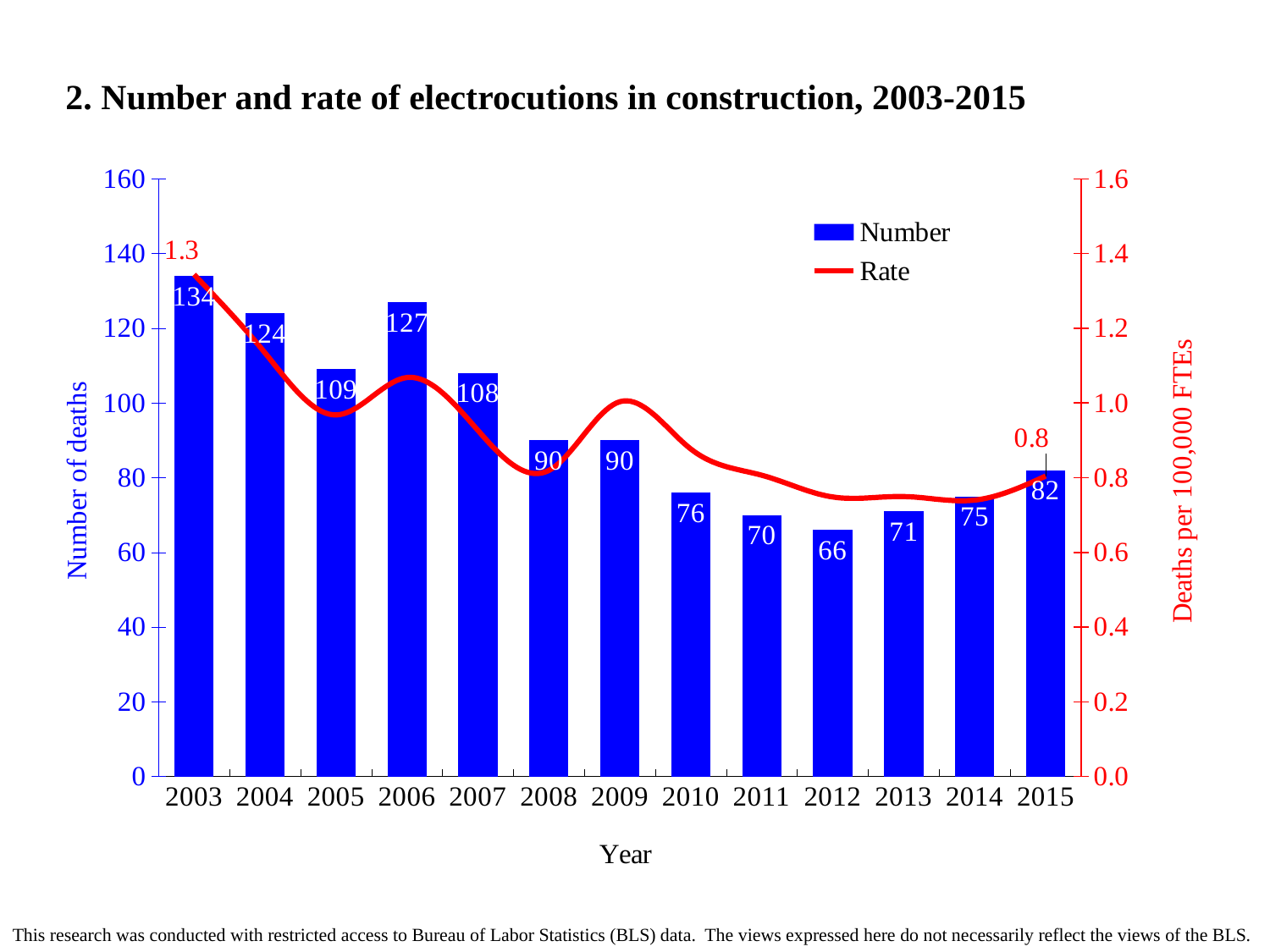
What kind of chart is used to show the number of deaths? bar chart What was the rate of electrocutions per 100,000 FTEs in 2015? 0.8 Is the rate of electrocutions in 2009 greater or less than 0.8 deaths per 100,000 FTEs? greater What was the number of electrocution deaths in construction in 2012? 66 How many years are shown on the x axis? 13 What is the difference in the number of deaths between 2003 and 2015? 52 What was the number of electrocution deaths in construction in 2003? 134 Which year had more electrocution deaths, 2006 or 2007? 2006 Which year had the lowest number of electrocution deaths? 2012 What is the label of the right-hand vertical axis? Deaths per 100,000 FTEs Which year had the highest number of electrocution deaths? 2003 How many series does the legend list? 2